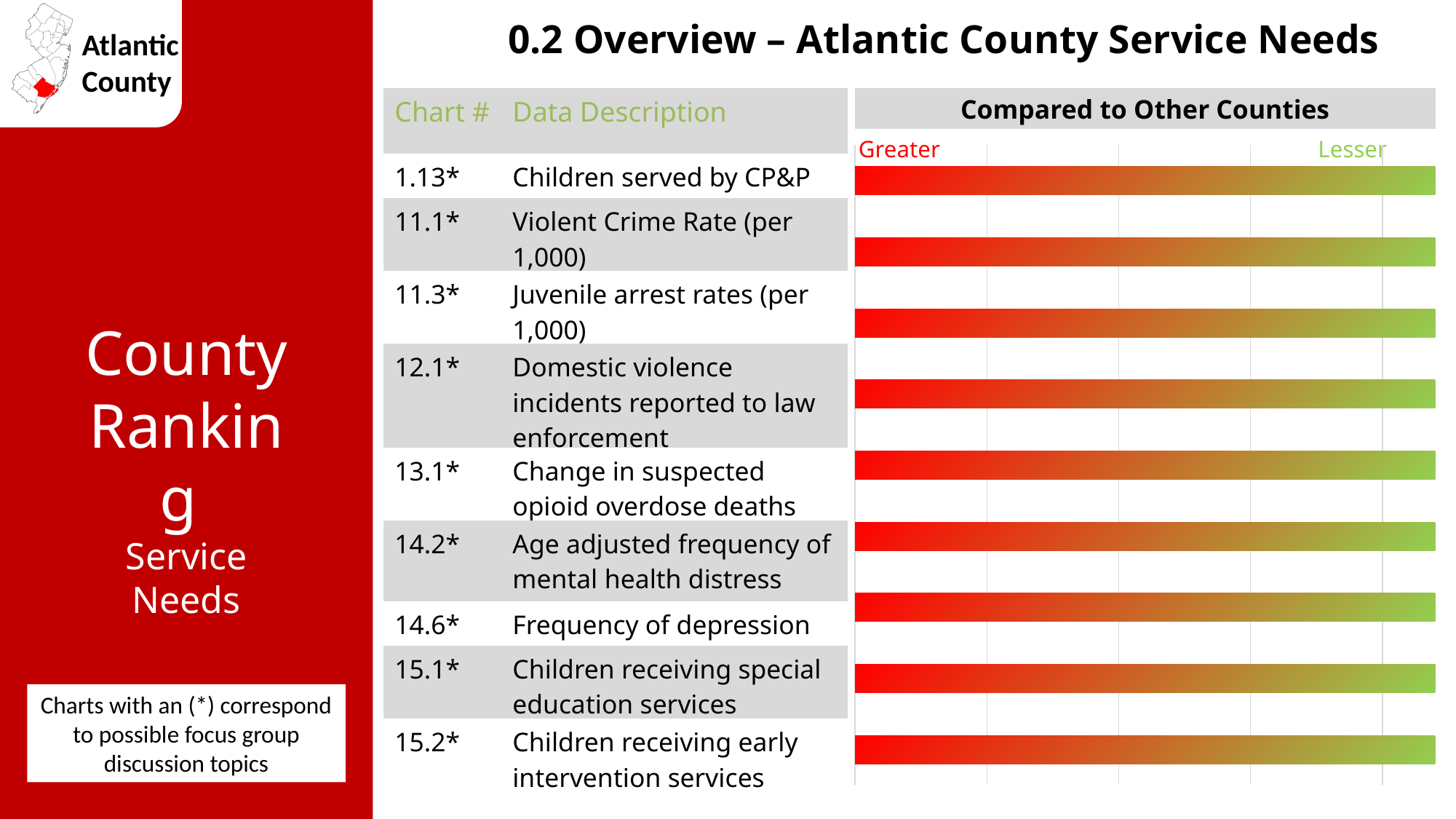
Which chart number corresponds to "Children served by CP&P"? 1.13* How many bars are plotted in the "Compared to Other Counties" chart? 9 What kind of chart is shown under "Compared to Other Counties"? bar chart Which data description corresponds to chart number 14.6*? Frequency of depression Are the bars in the chart oriented horizontally or vertically? horizontally What is the title of the chart on the right side of the slide? Compared to Other Counties What label appears at the left end of the chart's axis? Greater